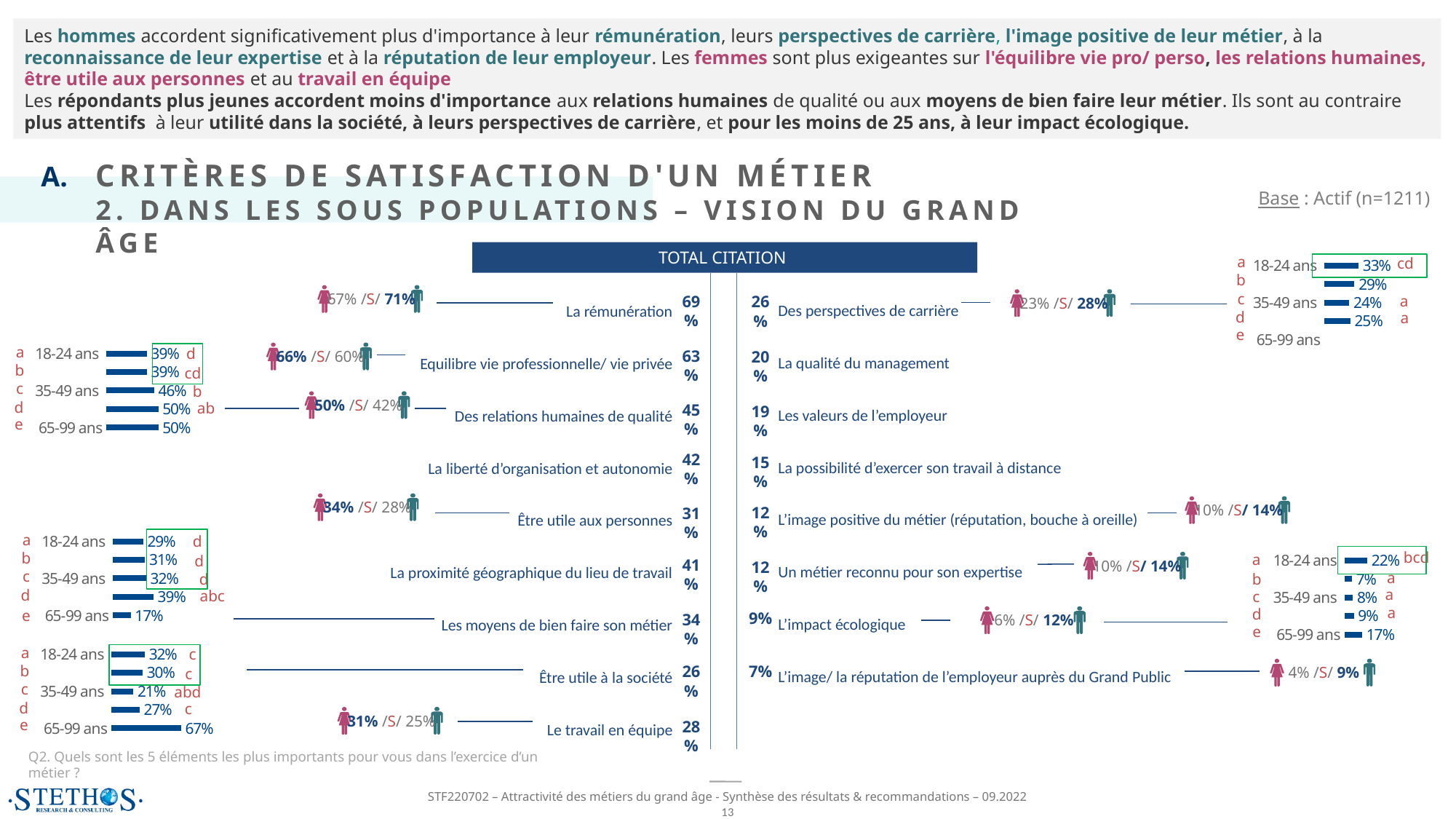
In the age-group bar chart next to 'Être utile à la société', which age group has the highest value? 65-99 ans In the age-group bar chart next to 'Des relations humaines de qualité', what is the value for 18-24 ans? 39% In the TOTAL CITATION list, which criterion has the lowest percentage? L'image/ la réputation de l'employeur auprès du Grand Public For 'L'impact écologique', what percentage is shown for men (the male figure)? 12% In the age-group bar chart next to 'Des perspectives de carrière', which is larger: 18-24 ans or 35-49 ans? 18-24 ans In the TOTAL CITATION list, what is the difference between 'Equilibre vie professionnelle/ vie privée' and 'Des relations humaines de qualité'? 18 percentage points In the age-group bar chart next to 'Les moyens de bien faire son métier', what is the value for 65-99 ans? 17% In the TOTAL CITATION list, which criterion has the highest percentage? La rémunération In the age-group bar chart next to 'L'impact écologique', what is the value for 18-24 ans? 22% In the age-group bar chart next to 'Être utile à la société', what is the difference between 65-99 ans and 18-24 ans? 35 percentage points In the age-group bar chart next to 'Des relations humaines de qualité', what is the value for 65-99 ans? 50% In the TOTAL CITATION list, what percentage is shown for 'La rémunération'? 69%